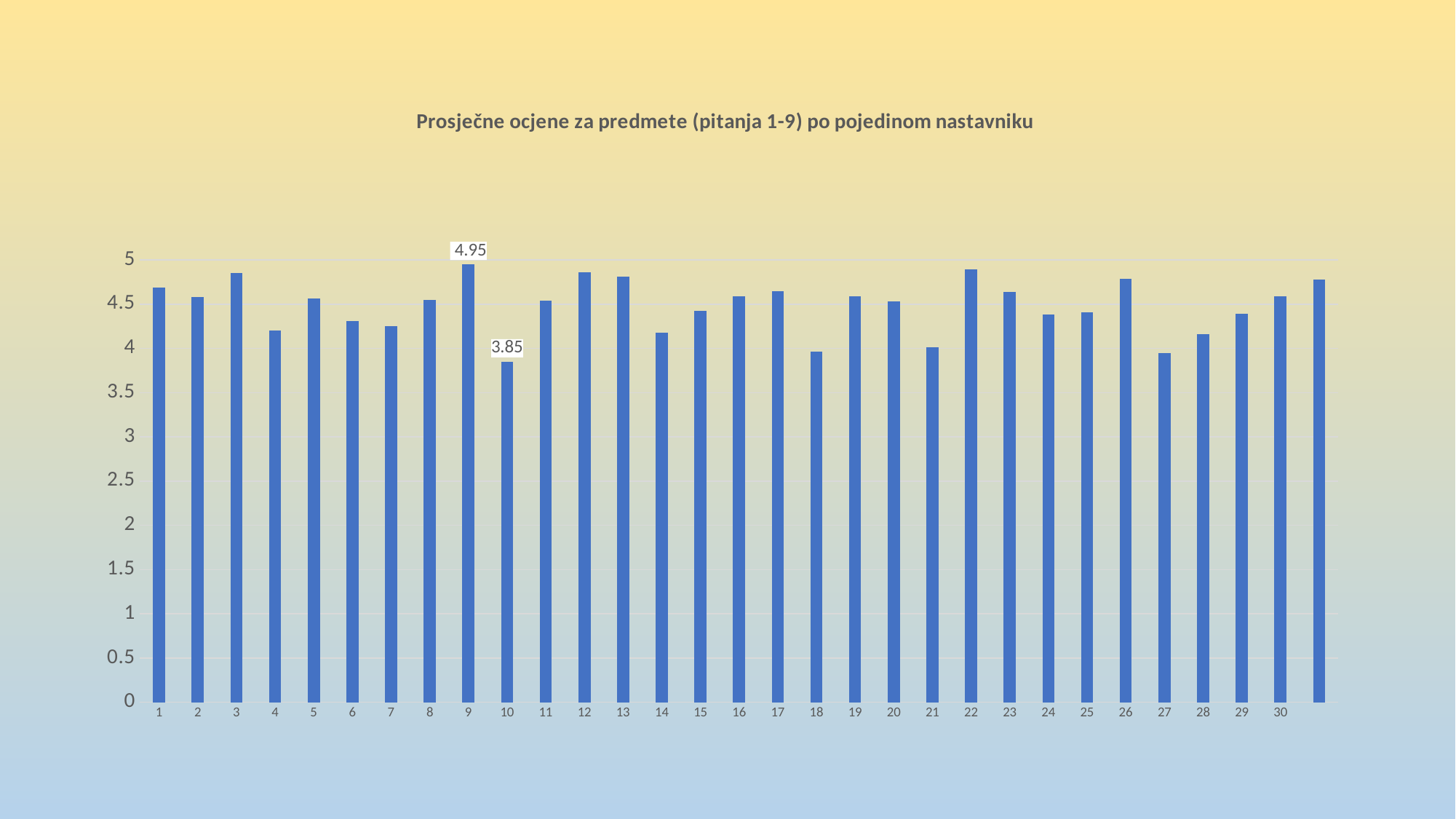
What is the title of the chart? Prosječne ocjene za predmete (pitanja 1-9) po pojedinom nastavniku What is the value for category 10? 3.85 What is the value for category 9? 4.95 Is the value for category 22 greater or less than 4.5? greater Is the value for category 3 greater or less than 4.5? greater What is the difference between the values for category 9 and category 10? 1.1 Which is larger, the value for category 3 or category 4? 3 Is the value for category 4 greater or less than 4.5? less Which category has the highest value? 9 What kind of chart is shown on the slide? bar chart Which category has the lowest value? 10